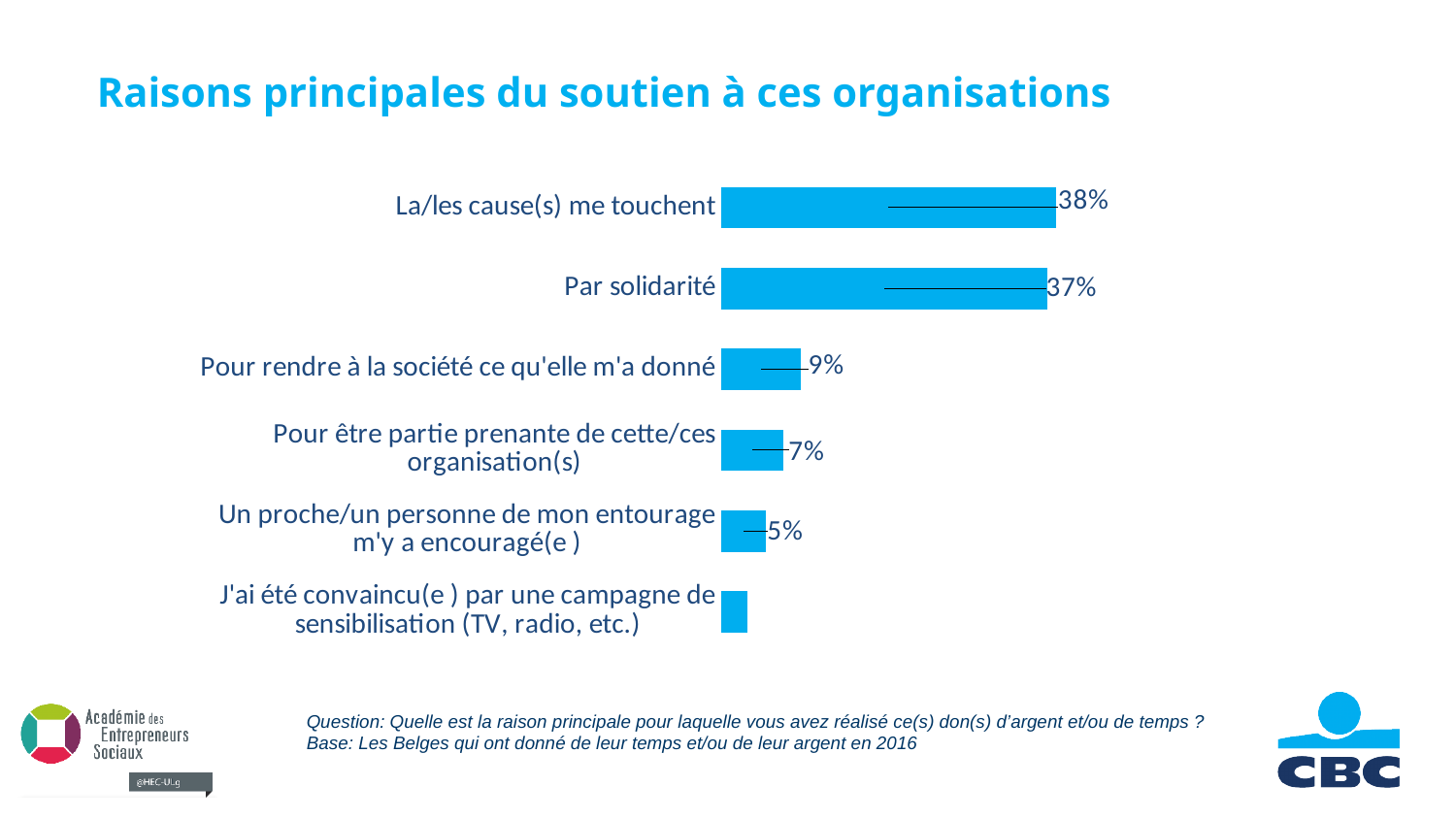
What type of chart is shown on the slide? Bar chart How many categories are shown in the chart? 6 Which category has the lowest value? J'ai été convaincu(e) par une campagne de sensibilisation (TV, radio, etc.) What is the value for "Un proche/un personne de mon entourage m'y a encouragé(e)"? 5% What is the value for "Pour rendre à la société ce qu'elle m'a donné"? 9% What is the value for "La/les cause(s) me touchent"? 38% What is the difference between "La/les cause(s) me touchent" and "Par solidarité"? 1 percentage point What is the value for "Par solidarité"? 37% Which is larger: "Par solidarité" or "Pour rendre à la société ce qu'elle m'a donné"? Par solidarité What is the value for "Pour être partie prenante de cette/ces organisation(s)"? 7% Which category has the highest value? La/les cause(s) me touchent What is the difference between "Pour rendre à la société ce qu'elle m'a donné" and "Pour être partie prenante de cette/ces organisation(s)"? 2 percentage points